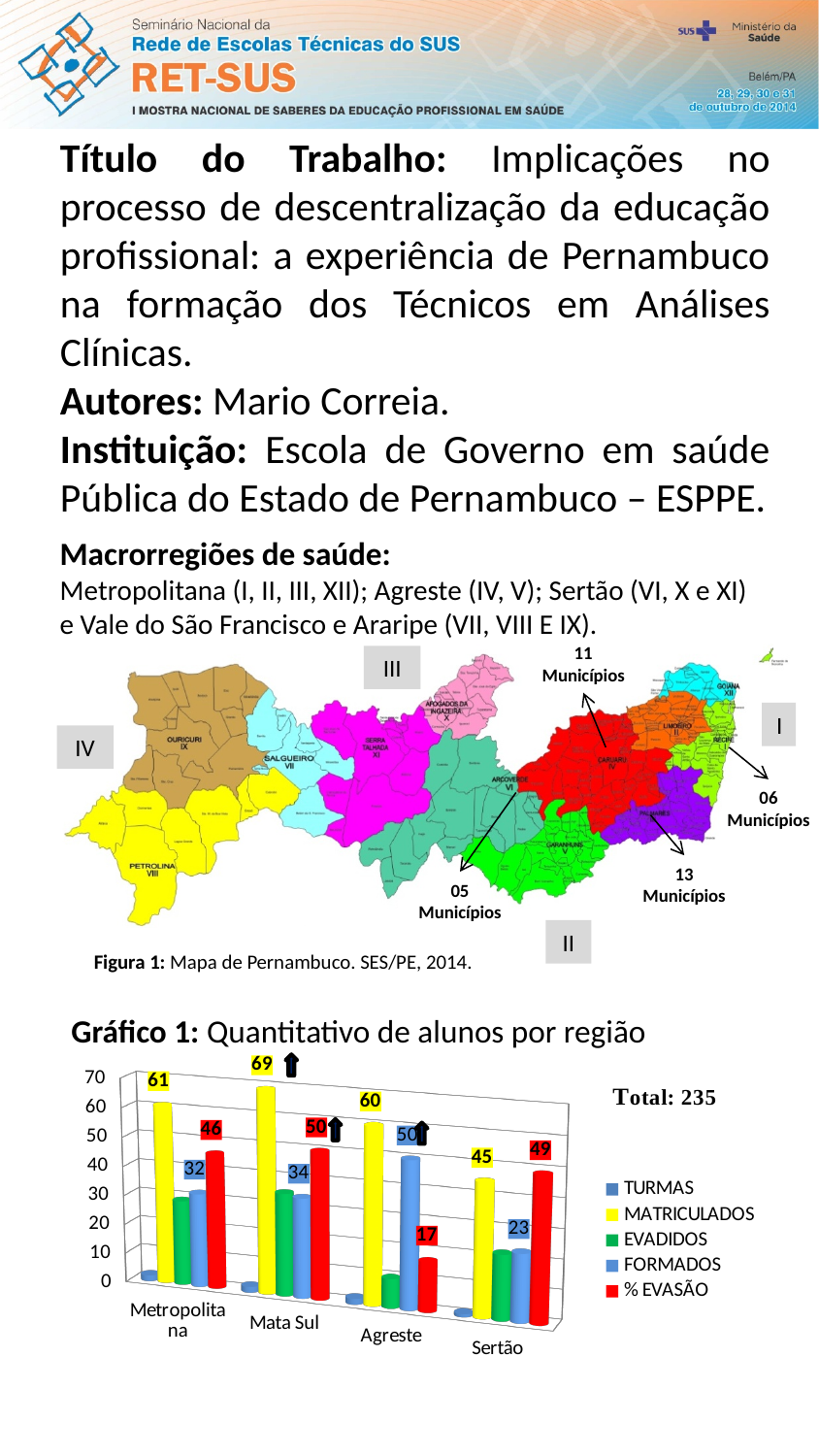
In Gráfico 1, which region has the lowest MATRICULADOS value? Sertão In Gráfico 1, what is the FORMADOS value for Agreste? 50 In Gráfico 1, what is the % EVASÃO value for Agreste? 17 In Gráfico 1, which region has the highest MATRICULADOS value? Mata Sul What kind of chart is Gráfico 1? bar chart In Gráfico 1, what is the % EVASÃO value for Sertão? 49 In Gráfico 1, what is the MATRICULADOS value for Mata Sul? 69 In Gráfico 1, what is the difference between the MATRICULADOS values for Mata Sul and Sertão? 24 In Gráfico 1, which region has the lowest FORMADOS value? Sertão How many regions are shown on the x axis of Gráfico 1? 4 How many series does the legend of Gráfico 1 list? 5 What total is printed next to Gráfico 1? Total: 235